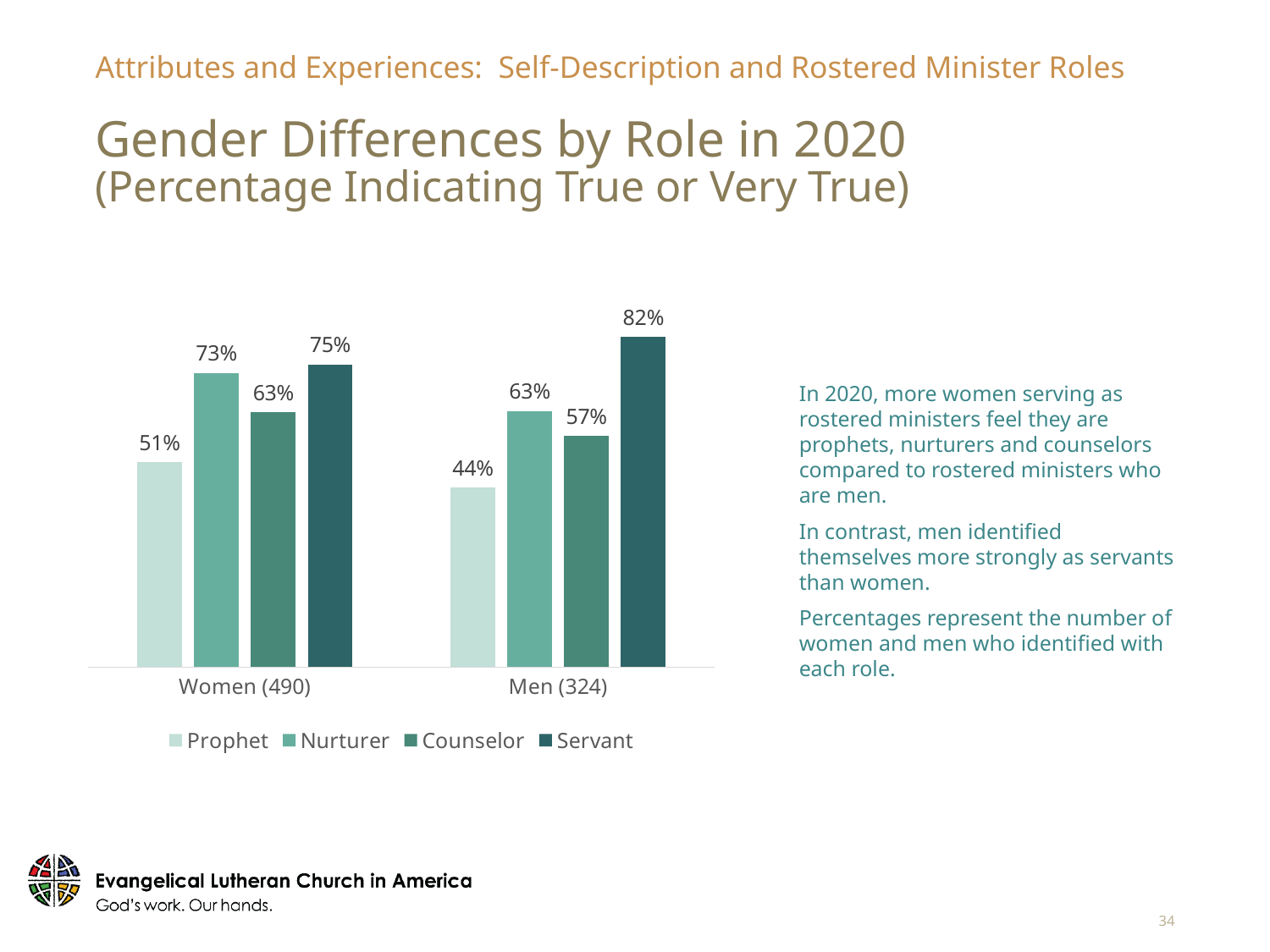
What percentage of women indicated the Prophet role was true or very true? 51% What is the difference between the Servant values for men and women? 7 percentage points Which role has the highest value for men? Servant What is the value for Servant among men? 82% Which is larger, the Counselor value for women or the Counselor value for men? Women How many women respondents are indicated in the x-axis label? 490 What is the value for Nurturer among women? 73% What kind of chart is shown on the slide? Bar chart What is the difference between the Nurturer values for women and men? 10 percentage points Which role has the lowest value for women? Prophet How many series does the legend list? 4 How many gender categories are shown on the x axis? 2